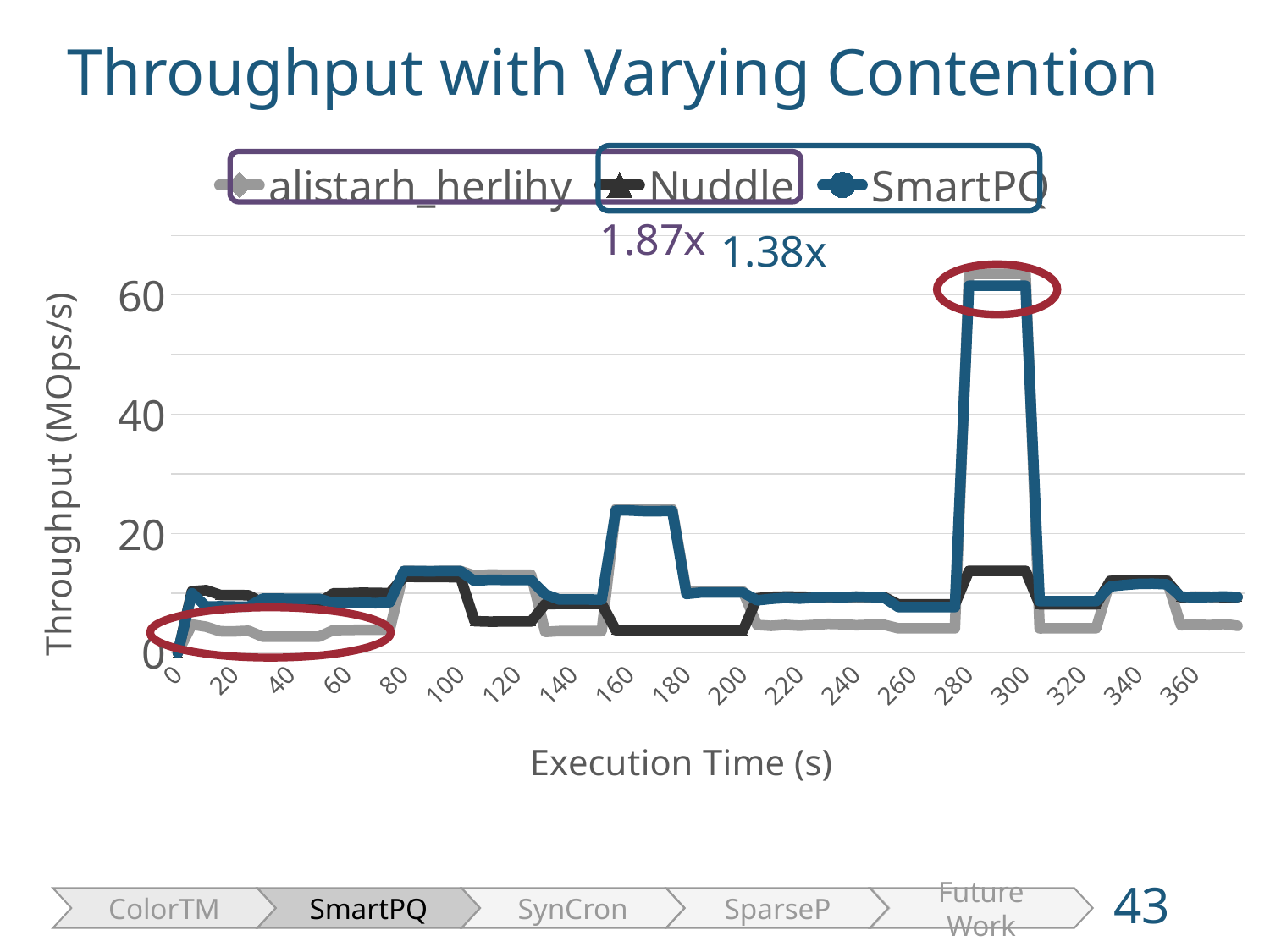
At execution time 30 s, which is larger: Nuddle or alistarh_herlihy? Nuddle Is the value for SmartPQ at execution time 290 s greater or less than 40? greater Is the value for alistarh_herlihy at execution time 30 s greater or less than 20? less What is the label of the y axis? Throughput (MOps/s) Is the value for SmartPQ at execution time 170 s greater or less than 20? greater How many series does the legend list? 3 What are the three series named in the legend? alistarh_herlihy, Nuddle, SmartPQ What kind of chart is shown on the slide? line chart Which series has the lowest throughput at execution time 170 s? Nuddle At execution time 290 s, which is larger: SmartPQ or Nuddle? SmartPQ